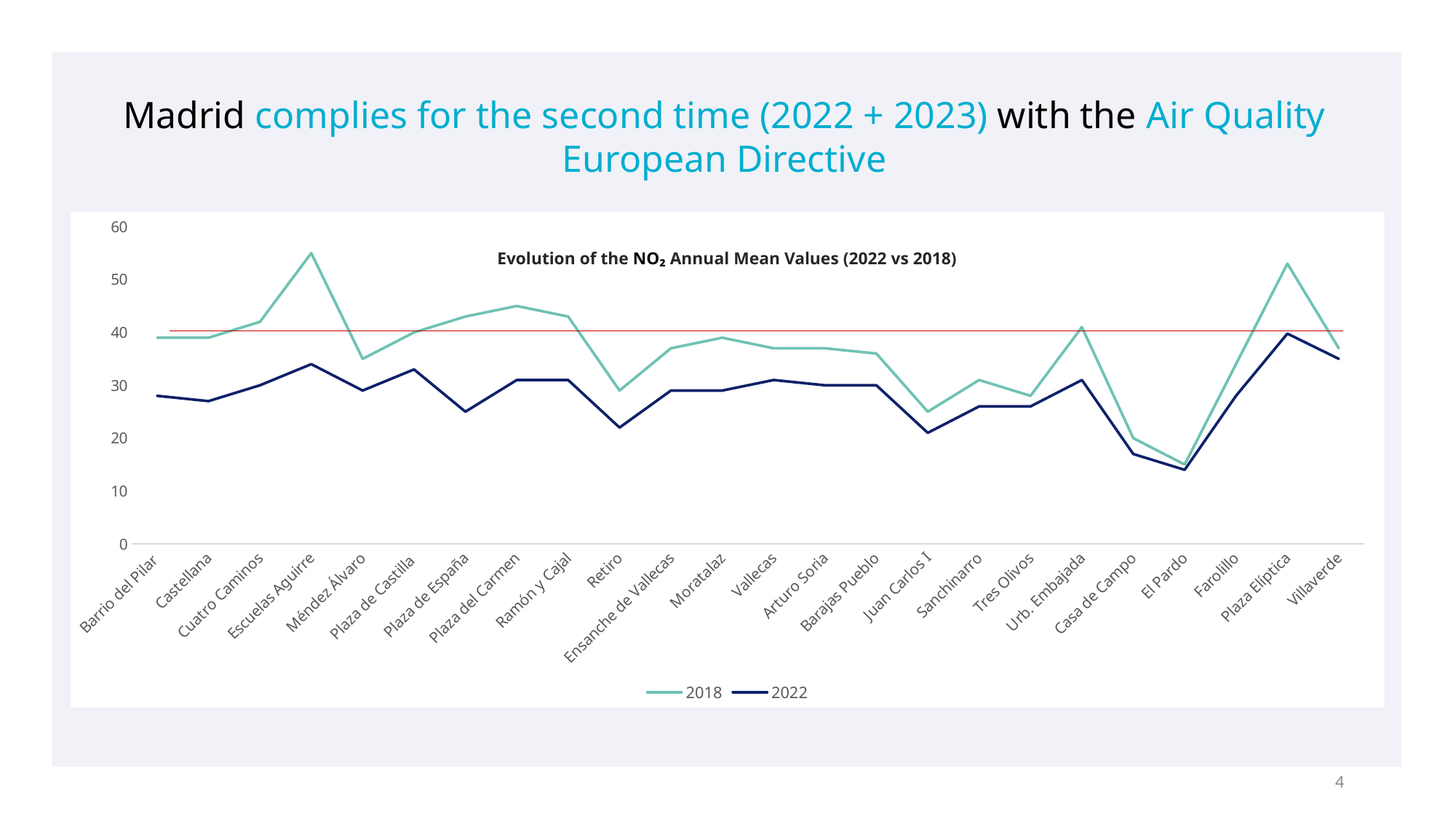
Which station has the lowest 2022 value? El Pardo Which station has the highest 2022 value? Plaza Elíptica How many monitoring stations are plotted along the x axis? 24 Is the 2018 value for Escuelas Aguirre greater or less than 50? greater What kind of chart is shown on the slide? Line chart How many series does the legend list? 2 Is the 2022 value for Juan Carlos I greater or less than 30? less At Escuelas Aguirre, which series has the larger value, 2018 or 2022? 2018 Which station has the lowest 2018 value? El Pardo For the 2018 series, which is larger: the value at Plaza Elíptica or the value at Villaverde? Plaza Elíptica Is the 2018 value for Casa de Campo greater or less than 30? less What is the title of the chart? Evolution of the NO₂ Annual Mean Values (2022 vs 2018)